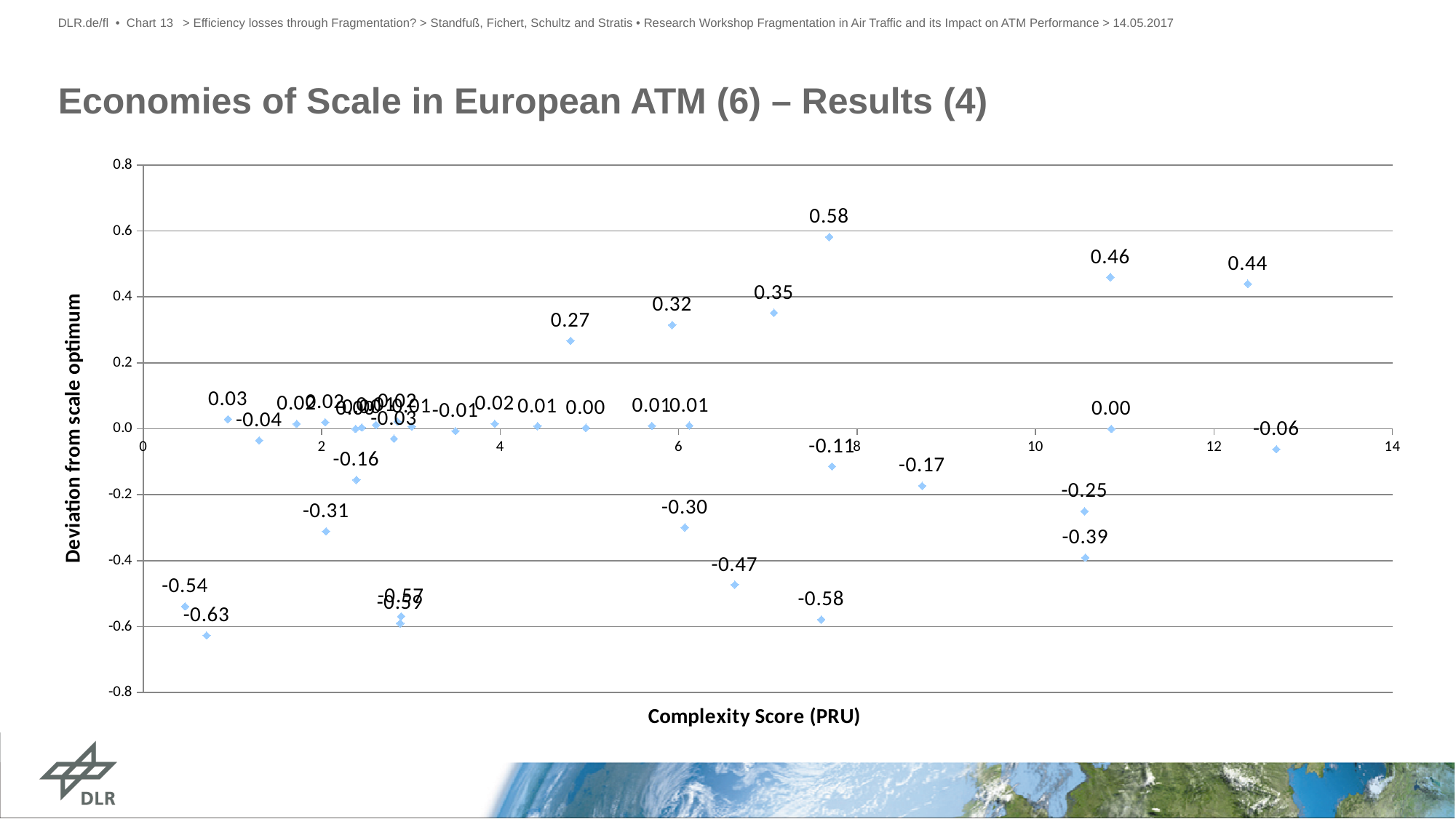
What is the title of the y axis? Deviation from scale optimum What is the highest data label value plotted on the chart? 0.58 What is the difference between the highest labelled value (0.58) and the lowest labelled value (-0.63)? 1.21 Is the value of the point with the highest complexity score greater or less than 0.2? less What is the title of the x axis? Complexity Score (PRU) How many points have a labelled value greater than 0.2? 6 What kind of chart is shown on the slide? scatter chart How many points have a labelled value below -0.4? 6 What is the lowest data label value plotted on the chart? -0.63 Which is larger, the point labelled 0.46 or the point labelled 0.44? 0.46 What is the labelled value of the point with the highest complexity score (furthest right on the x axis)? -0.06 What is the labelled value of the point with the lowest complexity score (furthest left on the x axis)? -0.54